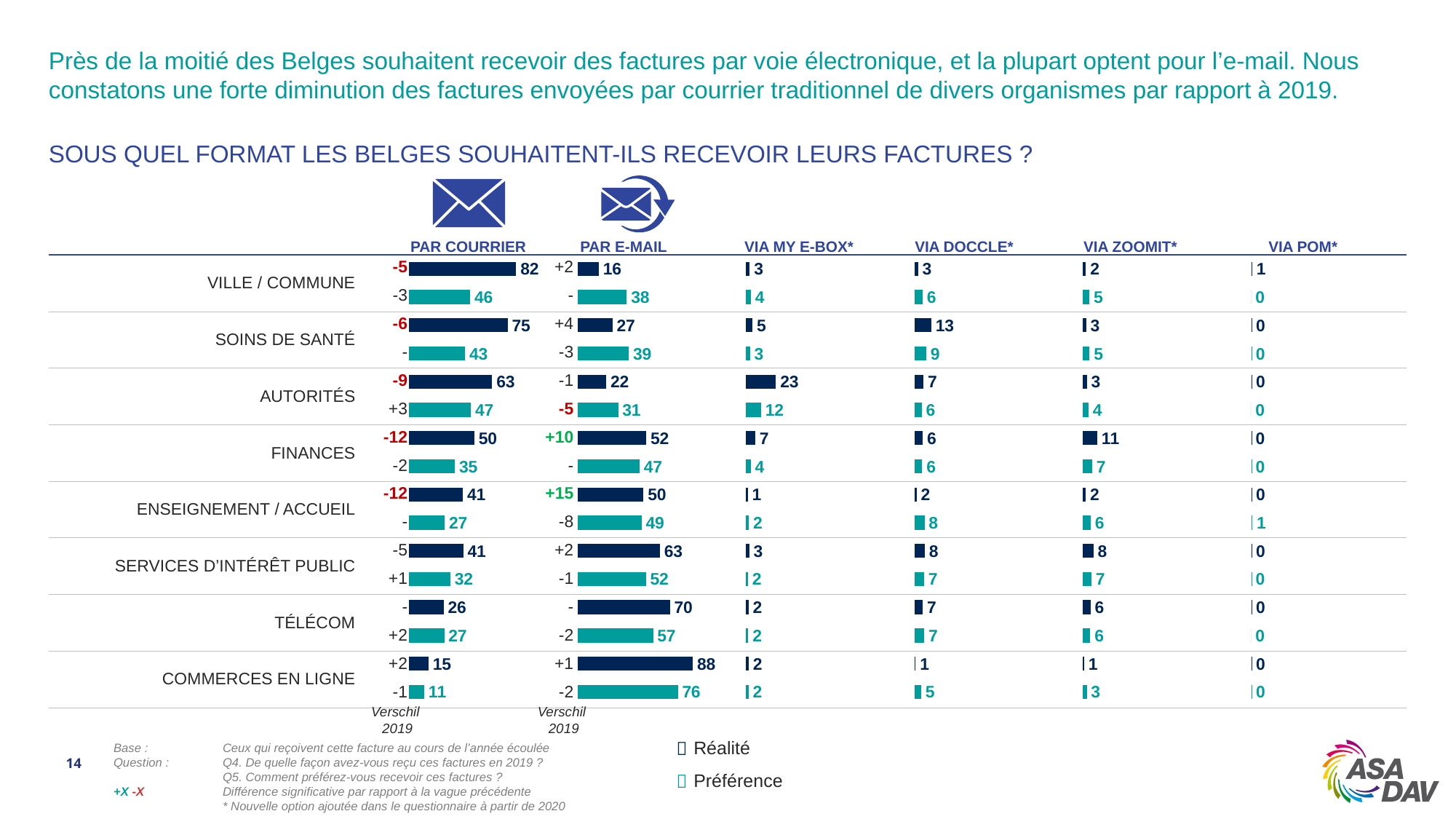
How many series does the legend list? 2 What kind of chart is used to show the values on this slide? Bar chart Under PAR E-MAIL, which is larger for FINANCES: the Réalité value or the Préférence value? Réalité What is the Réalité value for AUTORITÉS under VIA MY E-BOX*? 23 Which category has the highest Réalité value under PAR E-MAIL? COMMERCES EN LIGNE What is the difference between the Réalité and Préférence values for SOINS DE SANTÉ under PAR COURRIER? 32 How many categories (rows) are shown in the chart? 8 What is the Réalité value for SOINS DE SANTÉ under VIA DOCCLE*? 13 What is the Réalité value for VILLE / COMMUNE under PAR COURRIER? 82 Which category has the lowest Réalité value under PAR COURRIER? COMMERCES EN LIGNE Which colour represents the Préférence series in the legend? Teal What is the Préférence value for COMMERCES EN LIGNE under PAR E-MAIL? 76